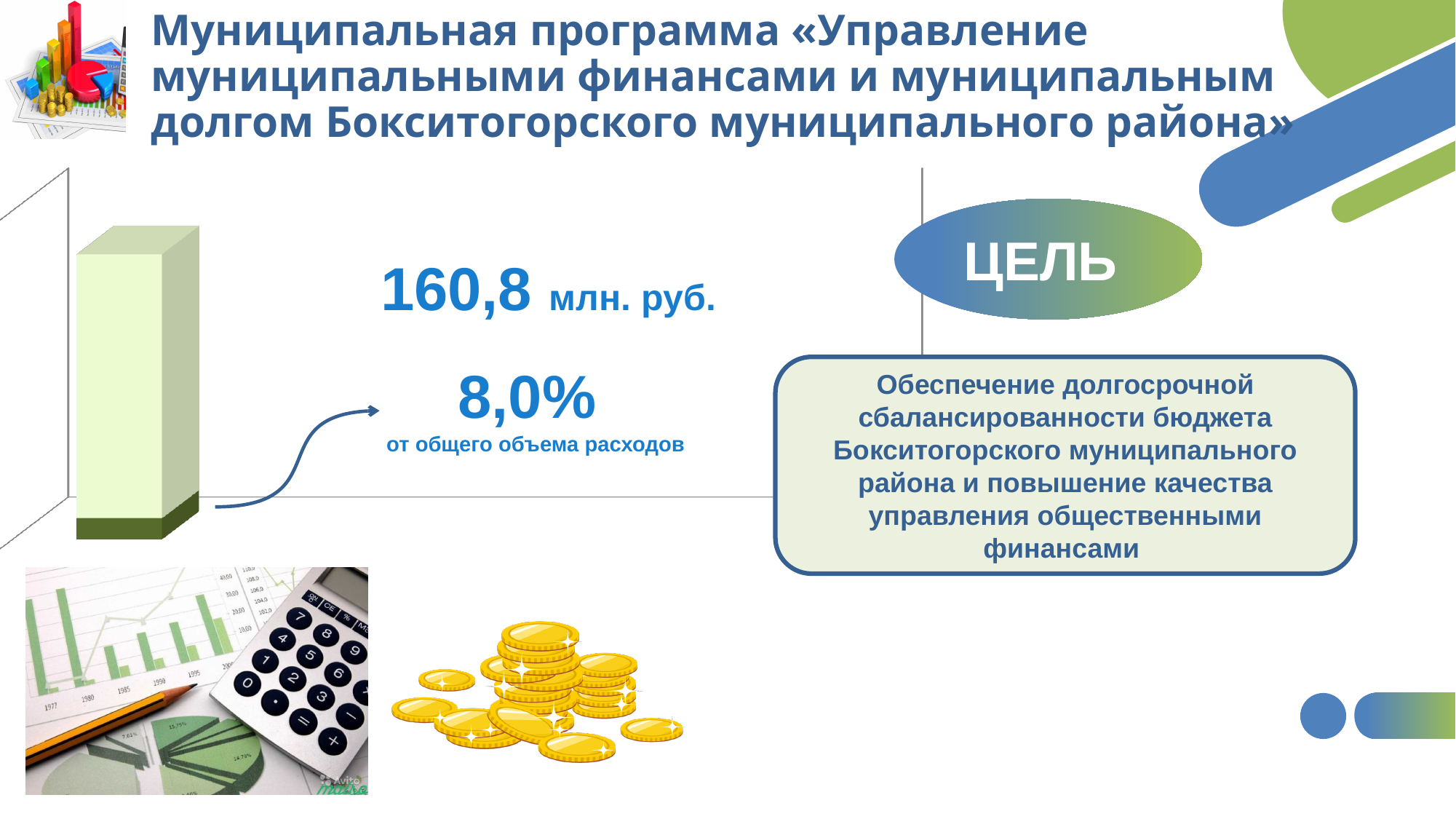
What value is printed for the highlighted dark green segment of the bar? 160,8 млн. руб. What kind of chart is shown on the left of the slide? bar chart Which segment of the bar is larger, the light green one or the dark green one? the light green one Into how many segments is the bar on the left of the slide divided? 2 How many bars does the chart on the left of the slide contain? 1 Is the share of the dark green segment greater or less than 10%? less What colour is the segment of the bar that the arrow points to? dark green What share of total expenditures does the highlighted dark green segment of the bar represent? 8,0% Where is the dark green segment located within the bar? at the bottom